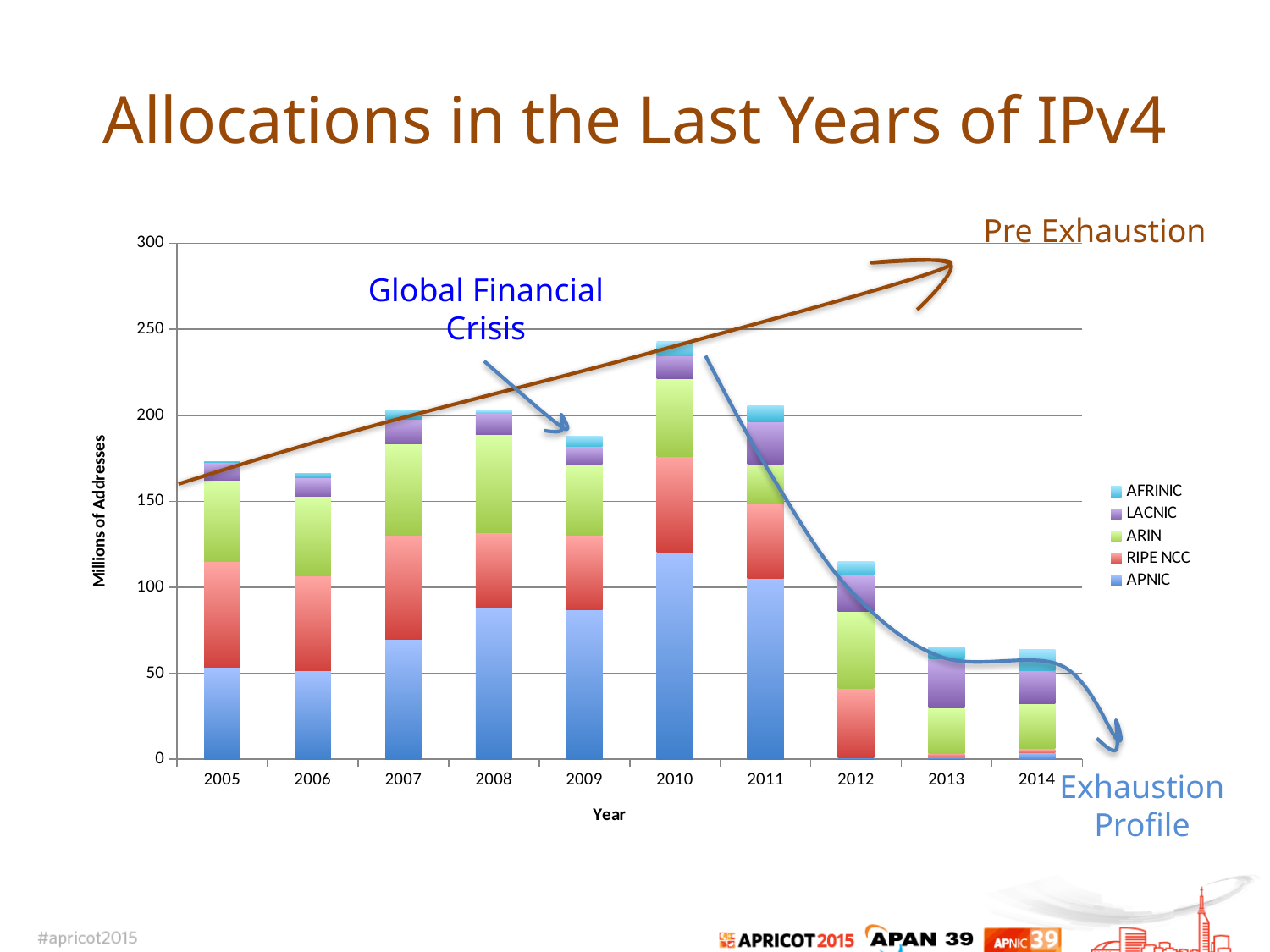
Is the total for 2013 greater or less than 100? less How many years are shown along the x axis of the chart? 10 What kind of chart is shown on the slide? Stacked bar chart Do the stacked bar totals rise or fall from 2010 to 2014? fall Which year has the tallest stacked bar in the chart? 2010 Is the total for 2005 greater or less than 150? greater Which year has the larger total, 2012 or 2013? 2012 How many series does the chart's legend list? 5 Which year has the larger total, 2007 or 2006? 2007 What is the label on the chart's vertical axis? Millions of Addresses Is the total for 2012 greater or less than 150? less